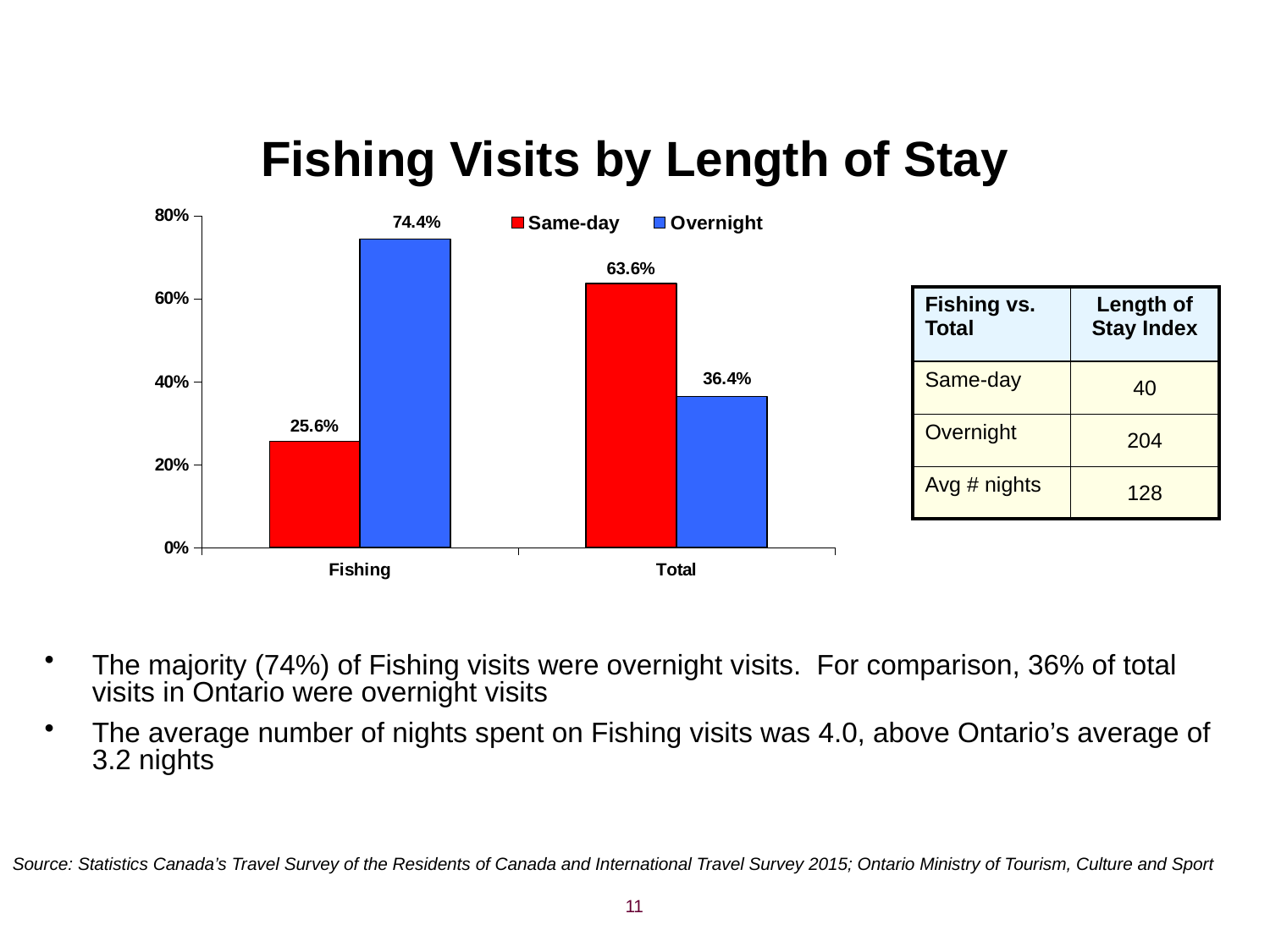
How many categories are shown on the x axis? 2 Which bar in the chart has the lowest value? Same-day for Fishing What is the Same-day value for Total? 63.6% How many series does the legend list? 2 What type of chart is shown on the slide? bar chart Is the Overnight value for Total greater or less than 40%? less What is the Overnight value for Fishing? 74.4% What is the Overnight value for Total? 36.4% What is the Same-day value for Fishing? 25.6% Which bar in the chart has the highest value? Overnight for Fishing Which is larger for Total: Same-day or Overnight? Same-day What is the difference between the Overnight and Same-day values for Fishing? 48.8%